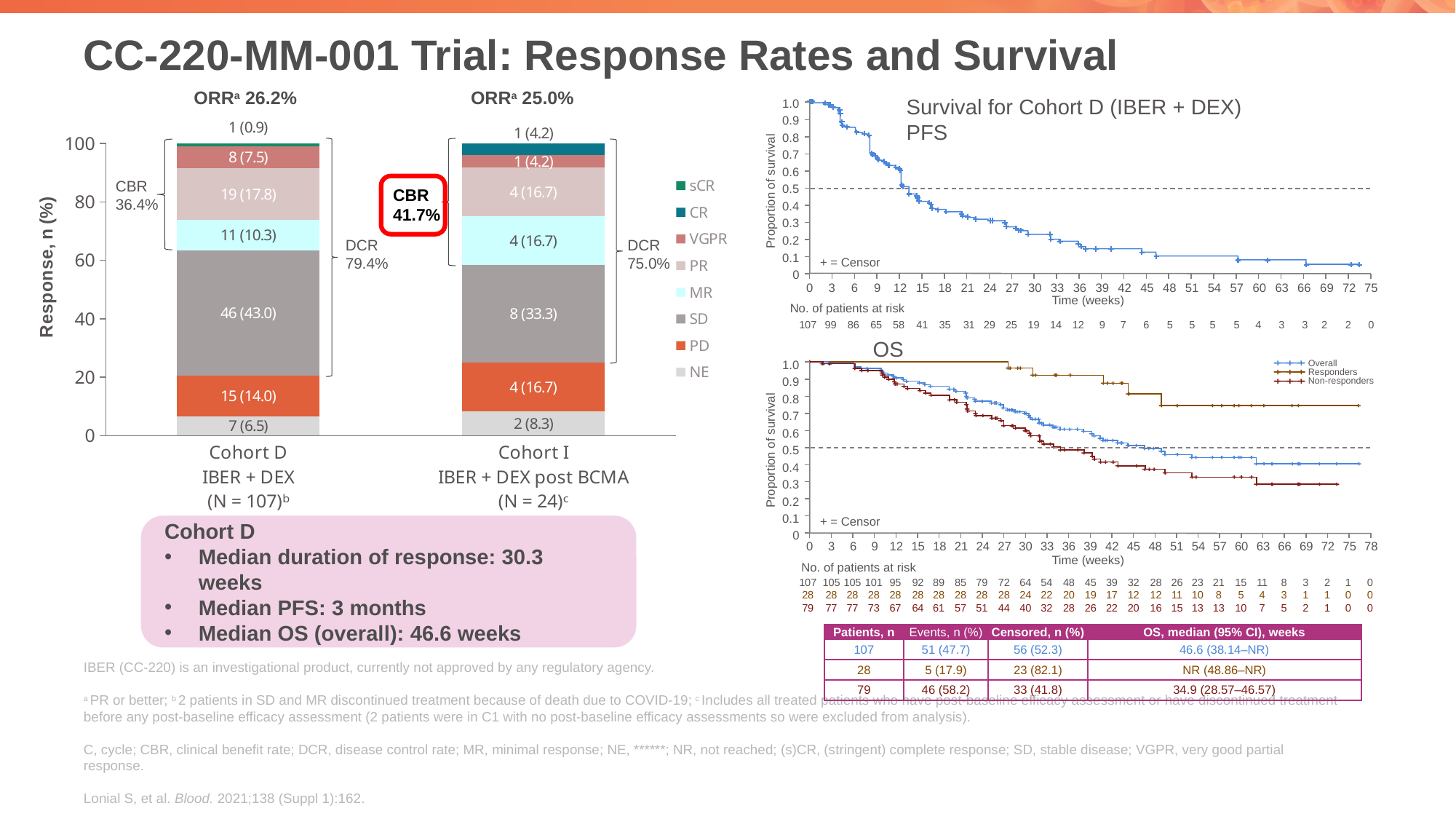
In the PFS survival chart for Cohort D, how many patients are at risk at time 0? 107 In the stacked bar chart, how many response categories does the legend list? 8 In the stacked bar chart, which response category is the largest segment of the Cohort D bar? SD In the stacked bar chart, what is the value labelled for PD in Cohort D? 15 (14.0) In the stacked bar chart, what is the value labelled for SD in Cohort D (IBER + DEX)? 46 (43.0) What kind of chart is used to show the response rates for Cohort D and Cohort I? Stacked bar chart In the stacked bar chart, what CBR is shown for Cohort I? 41.7% In the stacked bar chart, what ORR is shown above the Cohort D bar? 26.2% In the stacked bar chart, what DCR is shown for Cohort D? 79.4% In the stacked bar chart, what is the value labelled for NE in Cohort I (IBER + DEX post BCMA)? 2 (8.3) In the PFS survival chart, is the proportion of survival at 30 weeks greater or less than 0.5? less In the OS survival chart, how many series does the legend list? 3